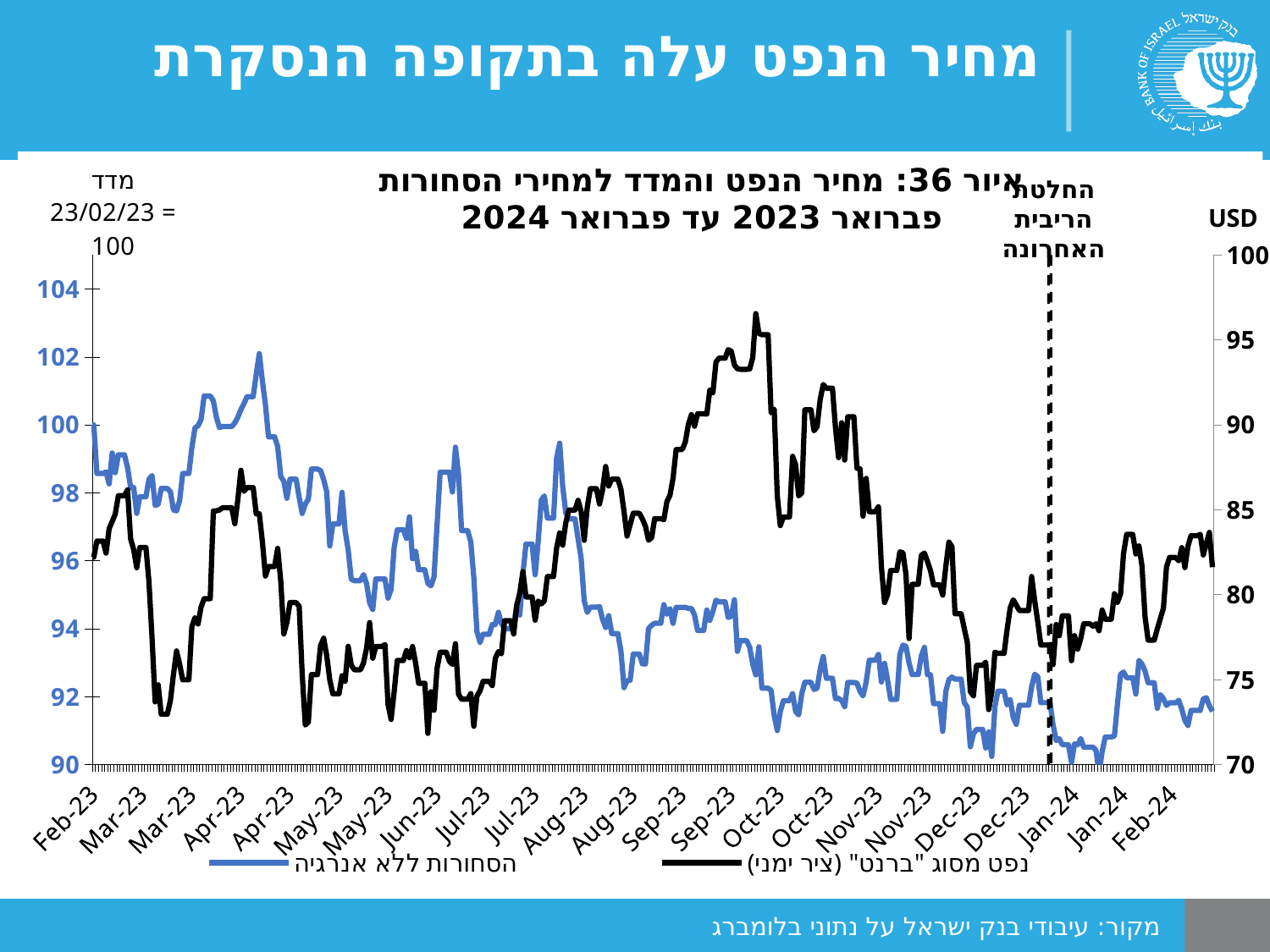
What unit is shown at the top of the right-hand axis? USD Does the non-energy commodities index (blue line) rise or fall between Apr-23 and Jun-23? fall How many series does the legend list? 2 Which series is plotted on the right axis (ציר ימני)? נפט מסוג "ברנט" Is the Brent oil price (black line) in Jun-23 greater or less than 80 USD? less What kind of chart is shown on the slide? line chart Is the Brent oil price (black line) at the end of the series in Feb-24 greater or less than 80 USD? greater Does the Brent oil price (black line) rise or fall between its Sep-23 peak and Dec-23? fall Is the peak of the non-energy commodities index (blue line) in Apr-23 greater or less than 100? greater Does the Brent oil price (black line) rise or fall between Jun-23 and Sep-23? rise